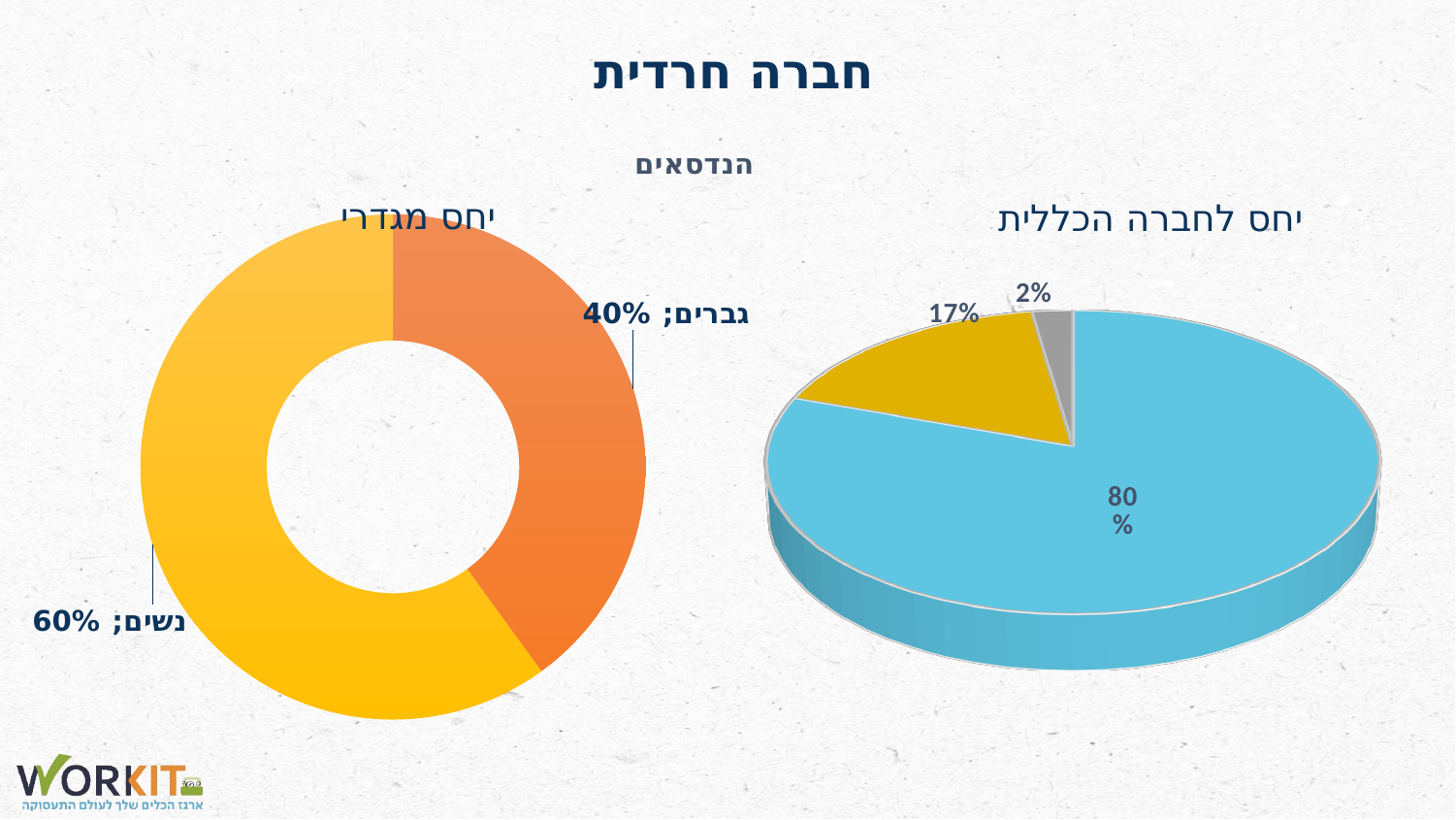
In the doughnut chart titled "יחס מגדרי", which category has the larger share? נשים In the doughnut chart titled "יחס מגדרי", what is the value for גברים? 40% In the pie chart titled "יחס לחברה הכללית", what is the value of the smallest slice? 2% What kind of chart is the chart on the right titled "יחס לחברה הכללית"? Pie chart In the doughnut chart titled "יחס מגדרי", what is the value for נשים? 60% In the pie chart titled "יחס לחברה הכללית", what is the value of the largest slice? 80% In the doughnut chart titled "יחס מגדרי", how many categories are shown? 2 In the pie chart titled "יחס לחברה הכללית", how many slices are shown? 3 In the doughnut chart titled "יחס מגדרי", which category has the smaller share? גברים In the pie chart titled "יחס לחברה הכללית", what is the difference between the largest slice and the 17% slice? 63% In the doughnut chart titled "יחס מגדרי", what is the difference between the share for נשים and the share for גברים? 20% What kind of chart is the chart on the left titled "יחס מגדרי"? Doughnut chart